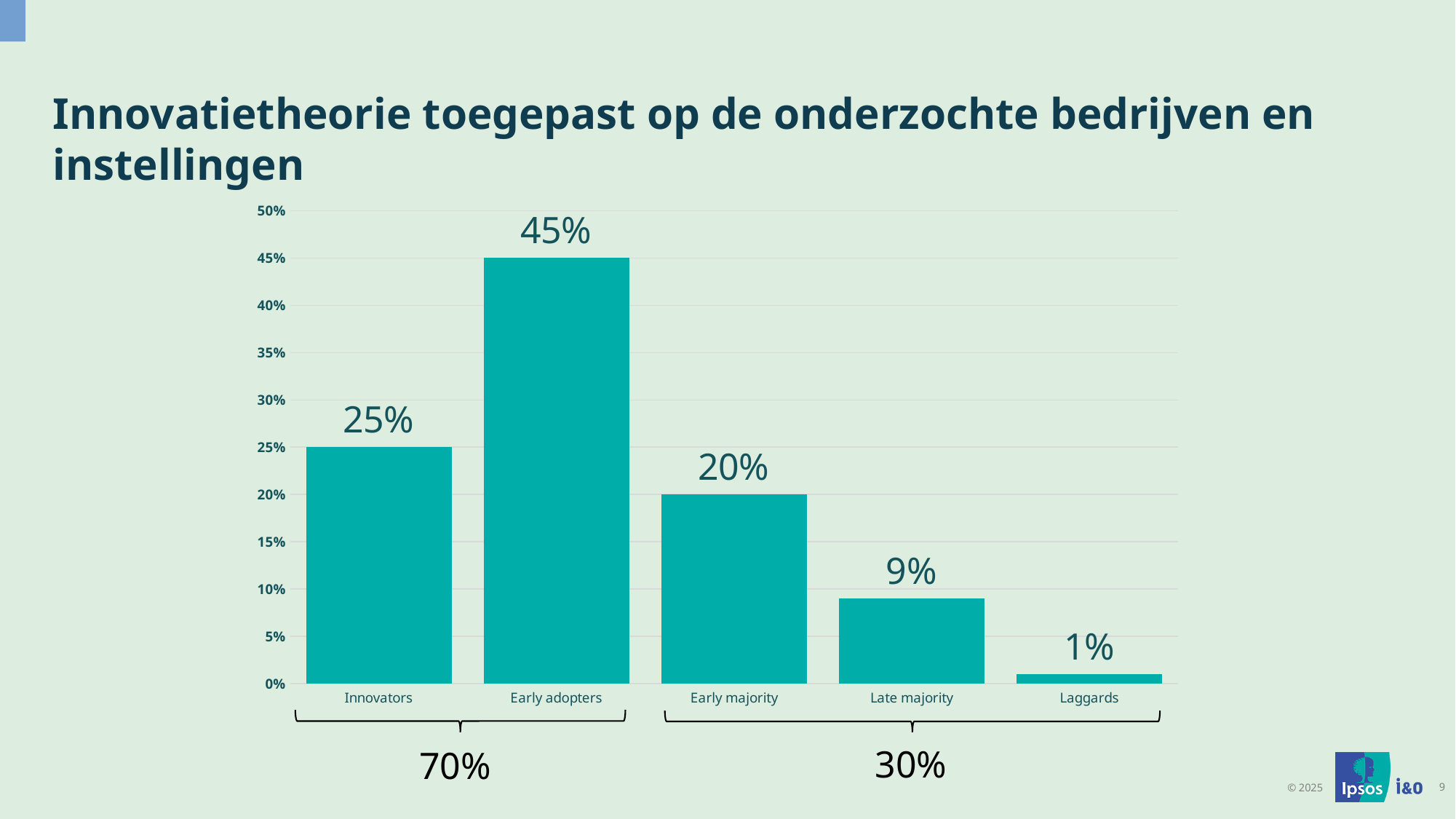
What is the value for Early adopters? 45% What is the difference between the values for Early adopters and Innovators? 20% Which category has the lowest value? Laggards What is the value for Late majority? 9% What is the combined percentage shown under the bracket for Innovators and Early adopters? 70% What is the value for Laggards? 1% Which is larger, the value for Innovators or the value for Early majority? Innovators Is the value for Early majority greater or less than 25%? less What kind of chart is shown on the slide? bar chart How many categories are shown on the x axis? 5 What is the combined percentage shown under the bracket for Early majority, Late majority and Laggards? 30% Which category has the highest value? Early adopters